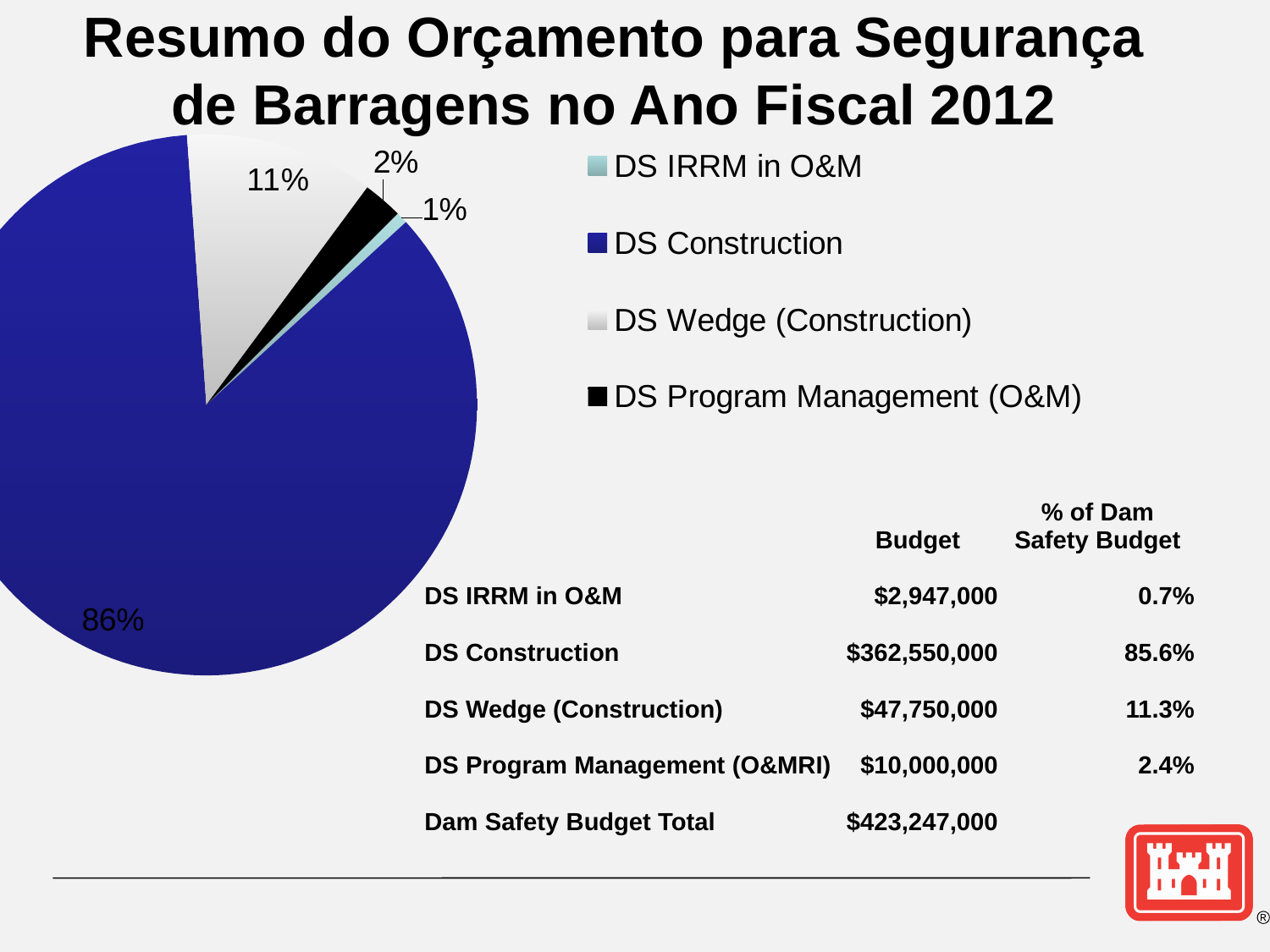
Which slice is larger in the pie chart, DS Wedge (Construction) or DS Program Management (O&M)? DS Wedge (Construction) How many slices does the pie chart have? 4 Which category has the smallest slice in the pie chart? DS IRRM in O&M What colour is the DS Program Management (O&M) slice in the pie chart? black What percentage label is shown on the DS Program Management (O&M) slice of the pie chart? 2% What kind of chart is shown on the slide? pie chart How many entries does the pie chart's legend list? 4 What percentage label is shown on the DS IRRM in O&M slice of the pie chart? 1% Which category has the largest slice in the pie chart? DS Construction What percentage label is shown on the DS Wedge (Construction) slice of the pie chart? 11% What is the difference in percentage points between the DS Construction slice and the DS Wedge (Construction) slice in the pie chart? 75% What percentage label is shown on the DS Construction slice of the pie chart? 86%